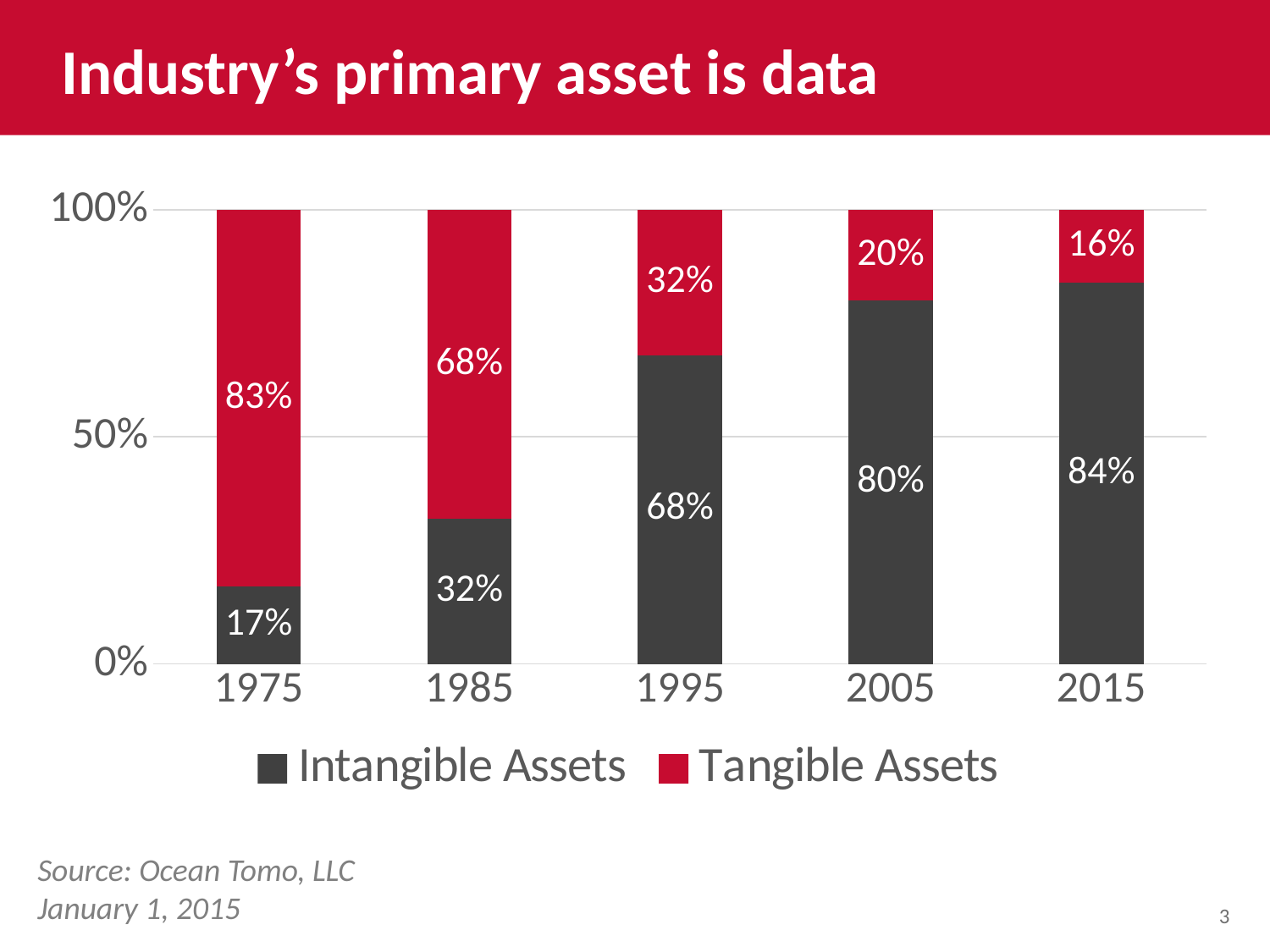
Which colour represents Tangible Assets in the chart? Red What is the value for Tangible Assets in 2005? 20% What is the difference between the Intangible Assets values for 2005 and 1985? 48% How many series does the legend list? 2 What kind of chart is shown on the slide? Stacked bar chart What is the value for Intangible Assets in 1975? 17% What is the value for Intangible Assets in 2015? 84% How many years are shown on the x axis? 5 In which year is the Tangible Assets value lowest? 2015 Which is larger in 1995: Intangible Assets or Tangible Assets? Intangible Assets In which year is the Intangible Assets value highest? 2015 Do the Intangible Assets values rise or fall from 1975 to 2015? Rise